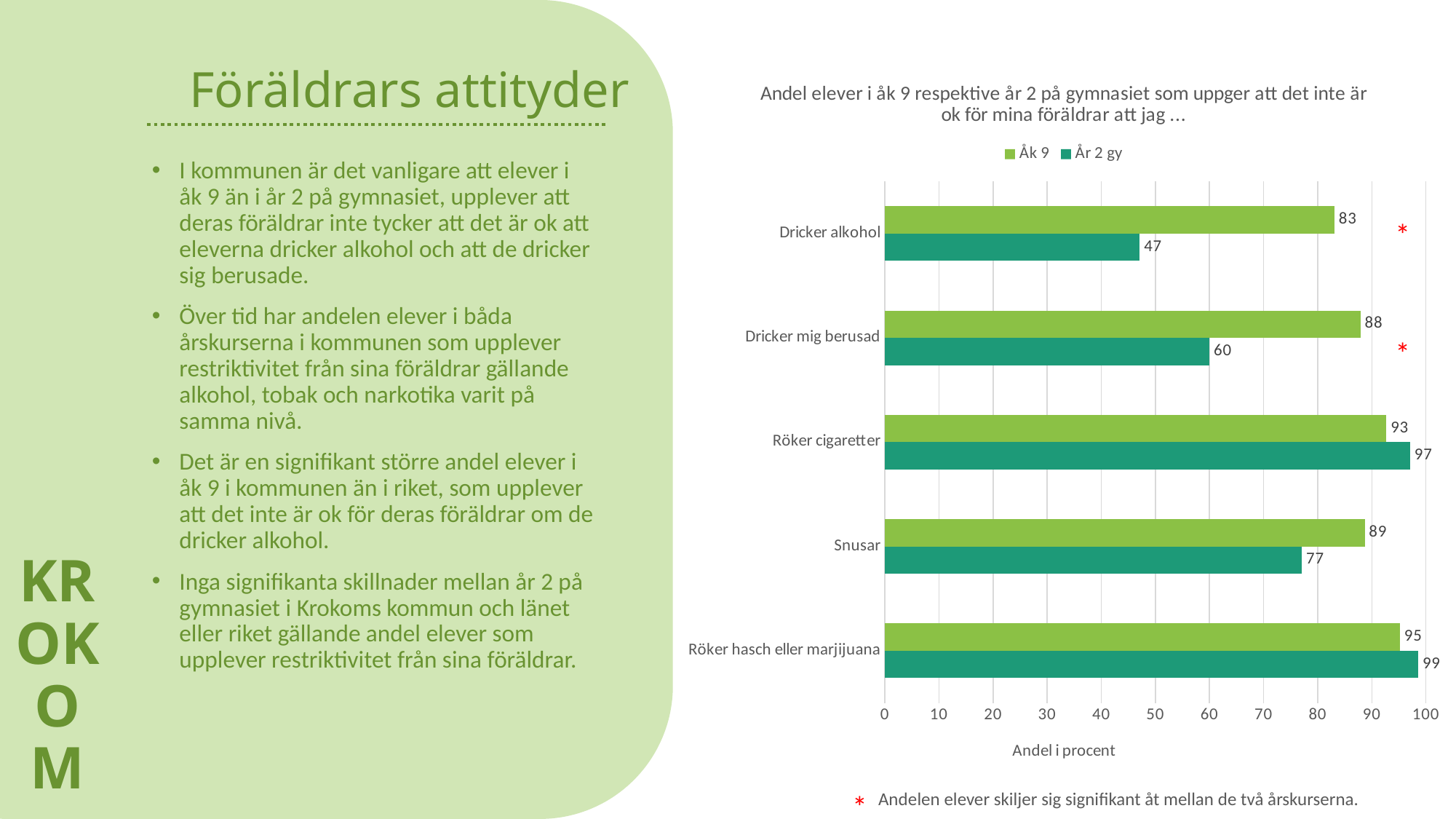
How many series does the legend list? 2 What is the value for Åk 9 for "Dricker alkohol"? 83 What is the difference between the Åk 9 and År 2 gy values for "Dricker alkohol"? 36 Which category has the lowest value for Åk 9? Dricker alkohol What kind of chart is shown on the slide? Bar chart What is the label of the x axis of the chart? Andel i procent Which category has the highest value for År 2 gy? Röker hasch eller marjijuana What is the difference between the Åk 9 and År 2 gy values for "Snusar"? 12 What is the value for År 2 gy for "Dricker mig berusad"? 60 What is the value for År 2 gy for "Snusar"? 77 For "Röker cigaretter", which series has the larger value, Åk 9 or År 2 gy? År 2 gy How many categories are shown on the chart? 5